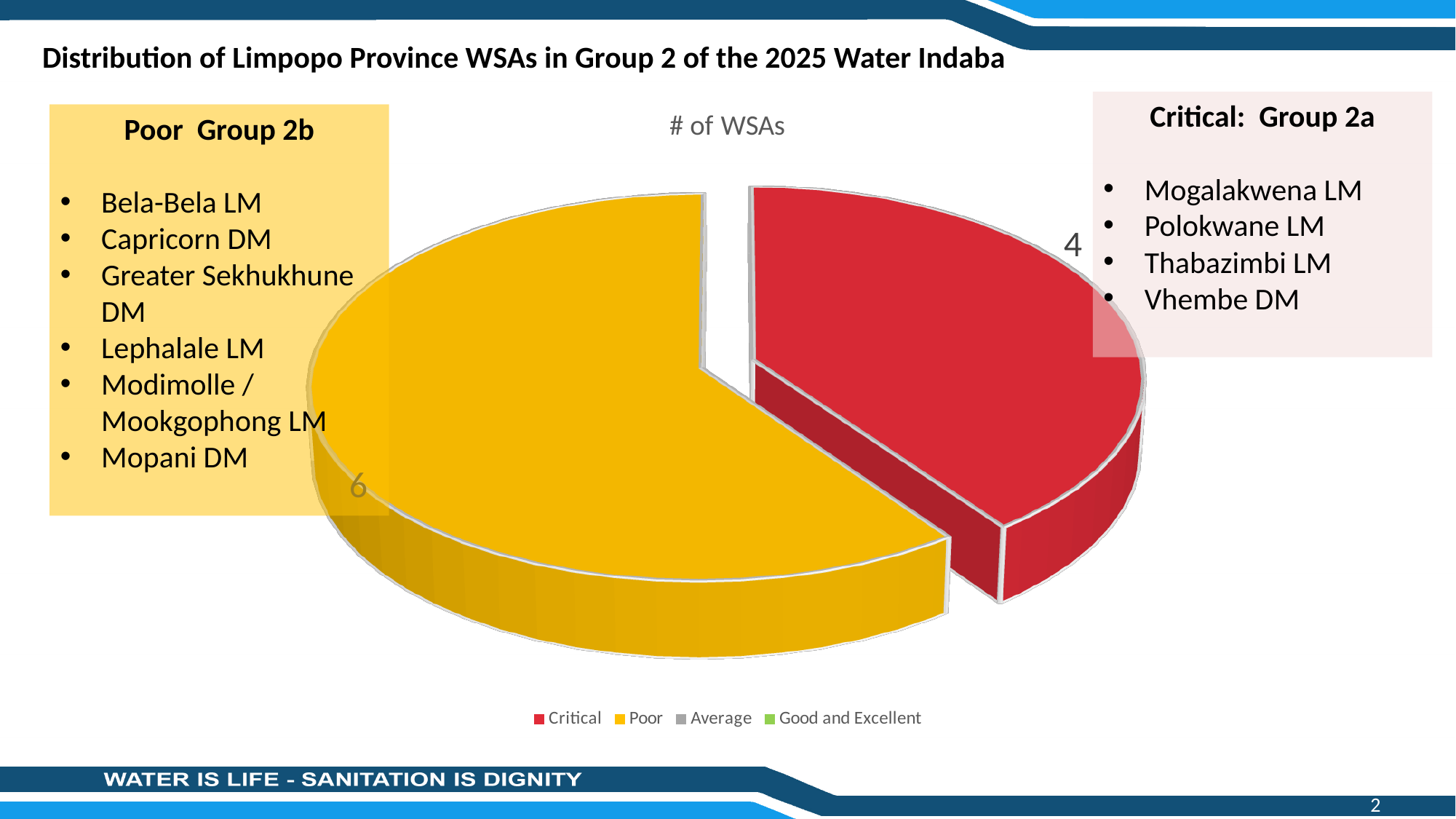
Which of the two visible slices is smaller, Critical or Poor? Critical What is the value of the Poor slice? 6 What colour is the Critical slice? red What kind of chart is shown on the slide? pie chart What is the difference between the Poor value and the Critical value? 2 Which category has the largest slice of the pie? Poor What share of the pie does the Poor slice represent? 60% What is the value of the Critical slice? 4 Is the value for Poor larger or smaller than the value for Critical? larger What is the title of the chart? # of WSAs What is the total number of WSAs represented by the visible slices of the pie? 10 How many entries does the chart legend list? 4